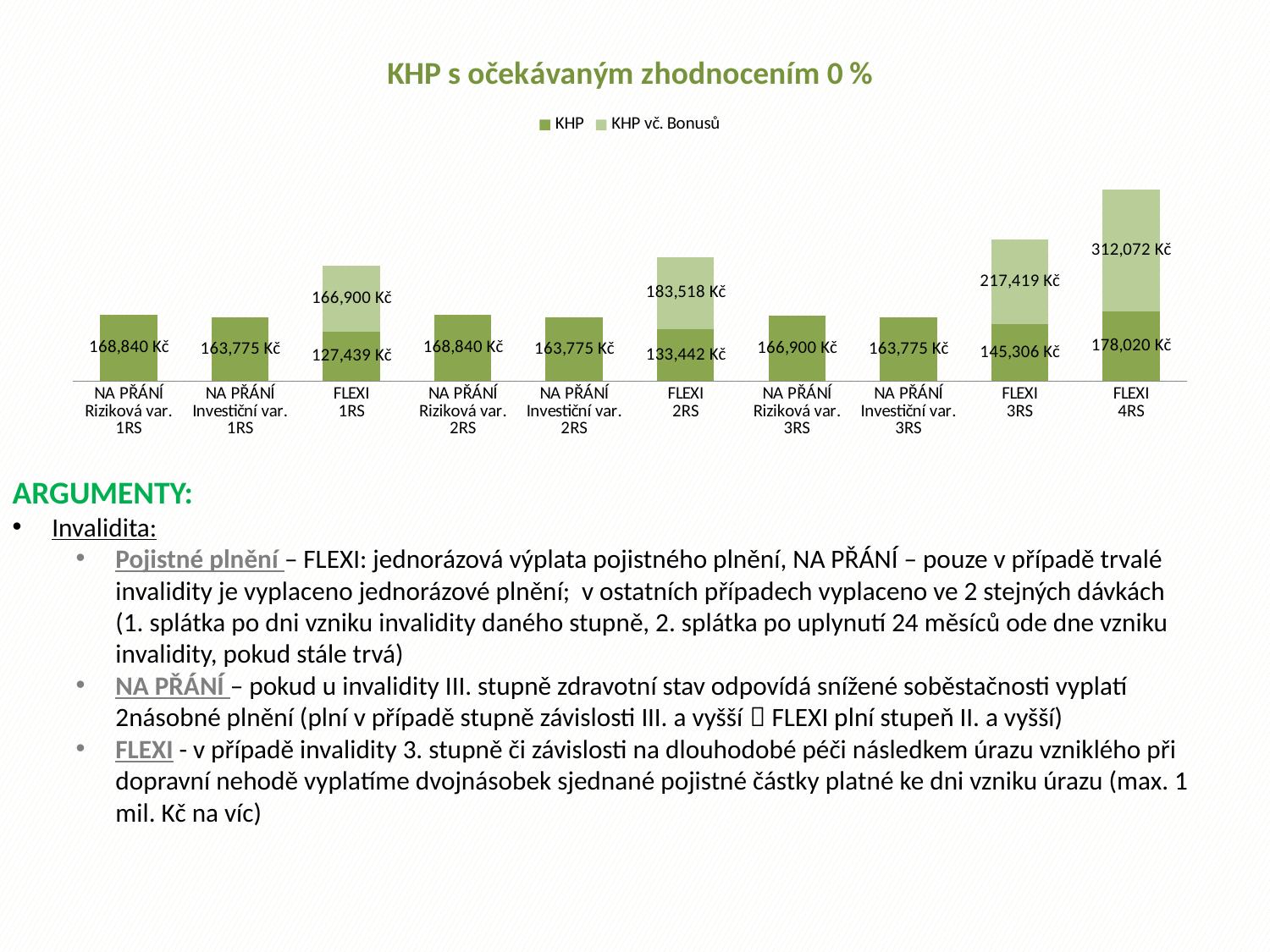
Which is larger: the KHP value for NA PŘÁNÍ Riziková var. 1RS or for NA PŘÁNÍ Investiční var. 1RS? NA PŘÁNÍ Riziková var. 1RS What is the KHP value for NA PŘÁNÍ Investiční var. 2RS? 163,775 Kč What is the title of the chart? KHP s očekávaným zhodnocením 0 % Which category has the highest KHP vč. Bonusů value? FLEXI 4RS How many categories are shown on the x axis of the chart? 10 What is the difference between the KHP vč. Bonusů value and the KHP value for FLEXI 4RS? 134,052 Kč How many series does the chart legend list? 2 What kind of chart is shown on the slide? Bar chart What is the KHP value for FLEXI 4RS? 178,020 Kč What is the KHP value for FLEXI 1RS? 127,439 Kč Which category has the lowest KHP value? FLEXI 1RS What is the KHP vč. Bonusů value for FLEXI 3RS? 217,419 Kč